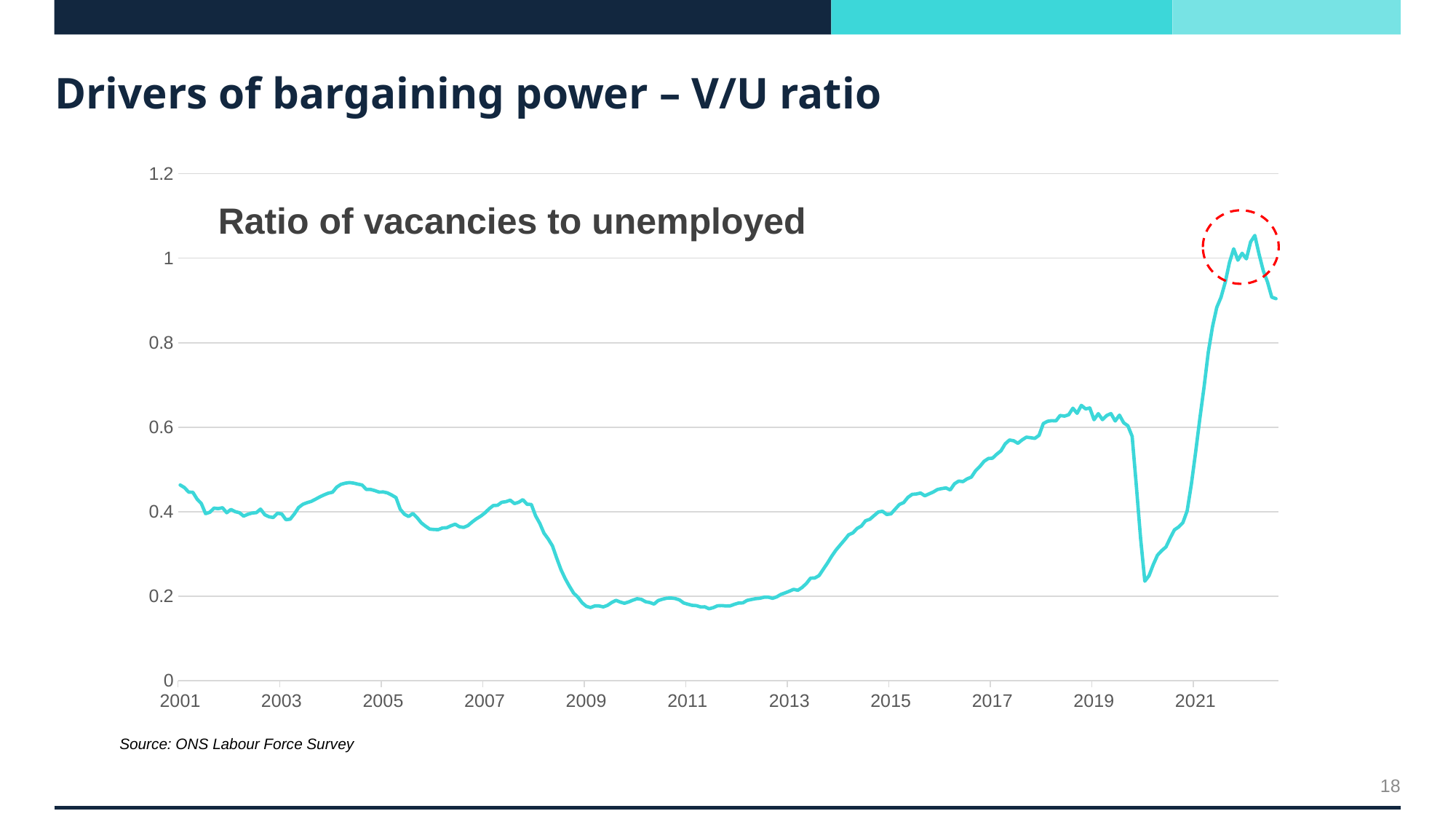
How many year labels are shown on the x axis? 11 What kind of chart is shown on the slide? line chart What is the title printed inside the chart? Ratio of vacancies to unemployed How many lines are plotted on the chart? 1 Between 2013 and 2019, does the ratio generally rise or fall? rise What source is cited below the chart? ONS Labour Force Survey Is the value of the ratio at 2019 greater or less than 0.4? greater Is the value of the ratio at 2011 greater or less than 0.4? less Between 2007 and 2009, does the ratio rise or fall? fall Is the peak value of the ratio after 2021 greater or less than 1? greater